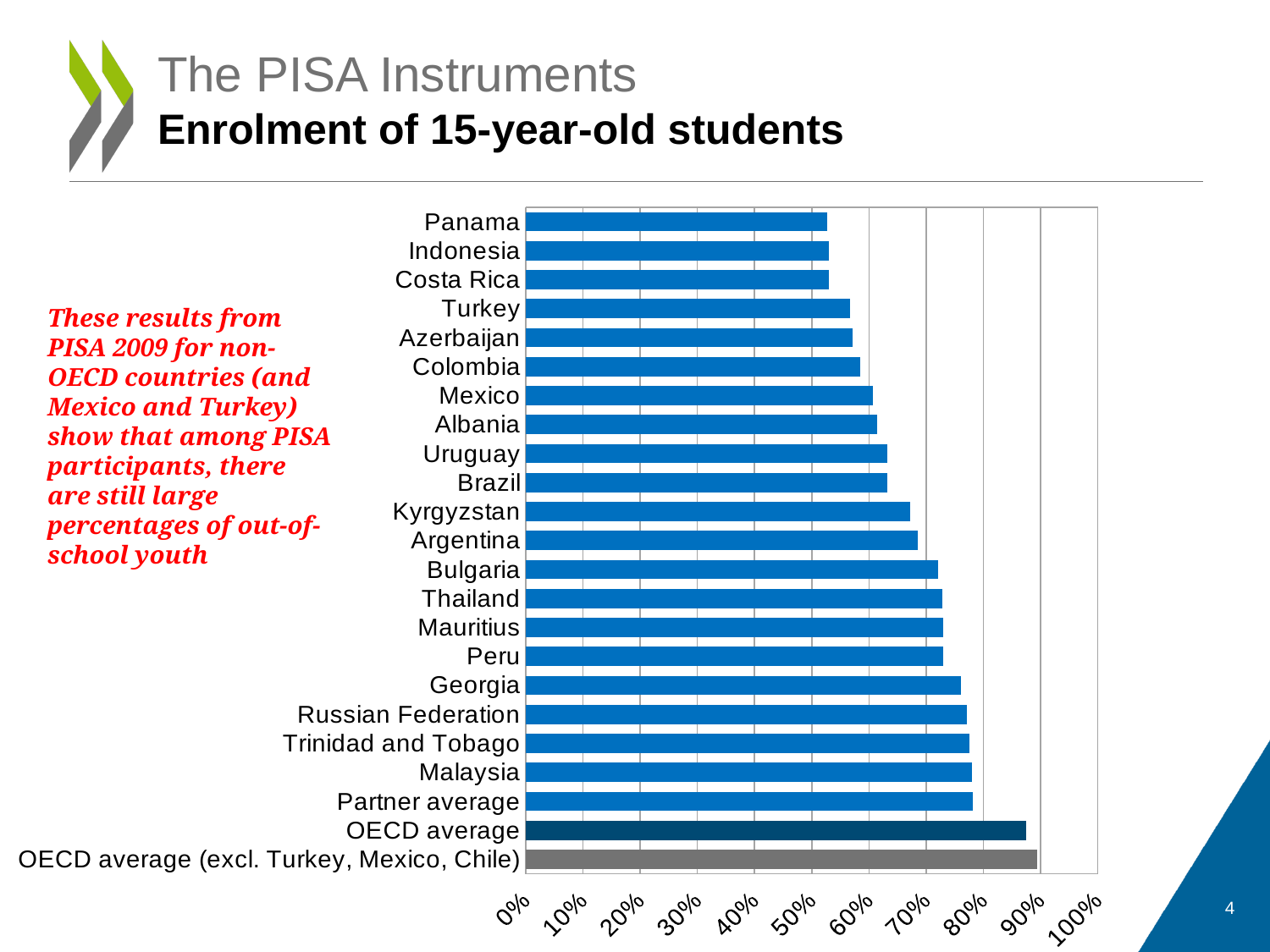
Which has a larger value, Turkey or Mexico? Mexico Is the value for OECD average greater or less than 80%? greater Do the bar values increase or decrease going from the top of the chart (Panama) to the bottom? increase Is the value for Panama greater or less than 60%? less Which has a larger value, Brazil or Georgia? Georgia Which category has the highest value in the chart? OECD average (excl. Turkey, Mexico, Chile) How many categories (bars) does the chart show? 23 What kind of chart is shown on the slide? bar chart What is the title of the chart shown on the slide? Enrolment of 15-year-old students Is the value for Malaysia greater or less than 80%? less